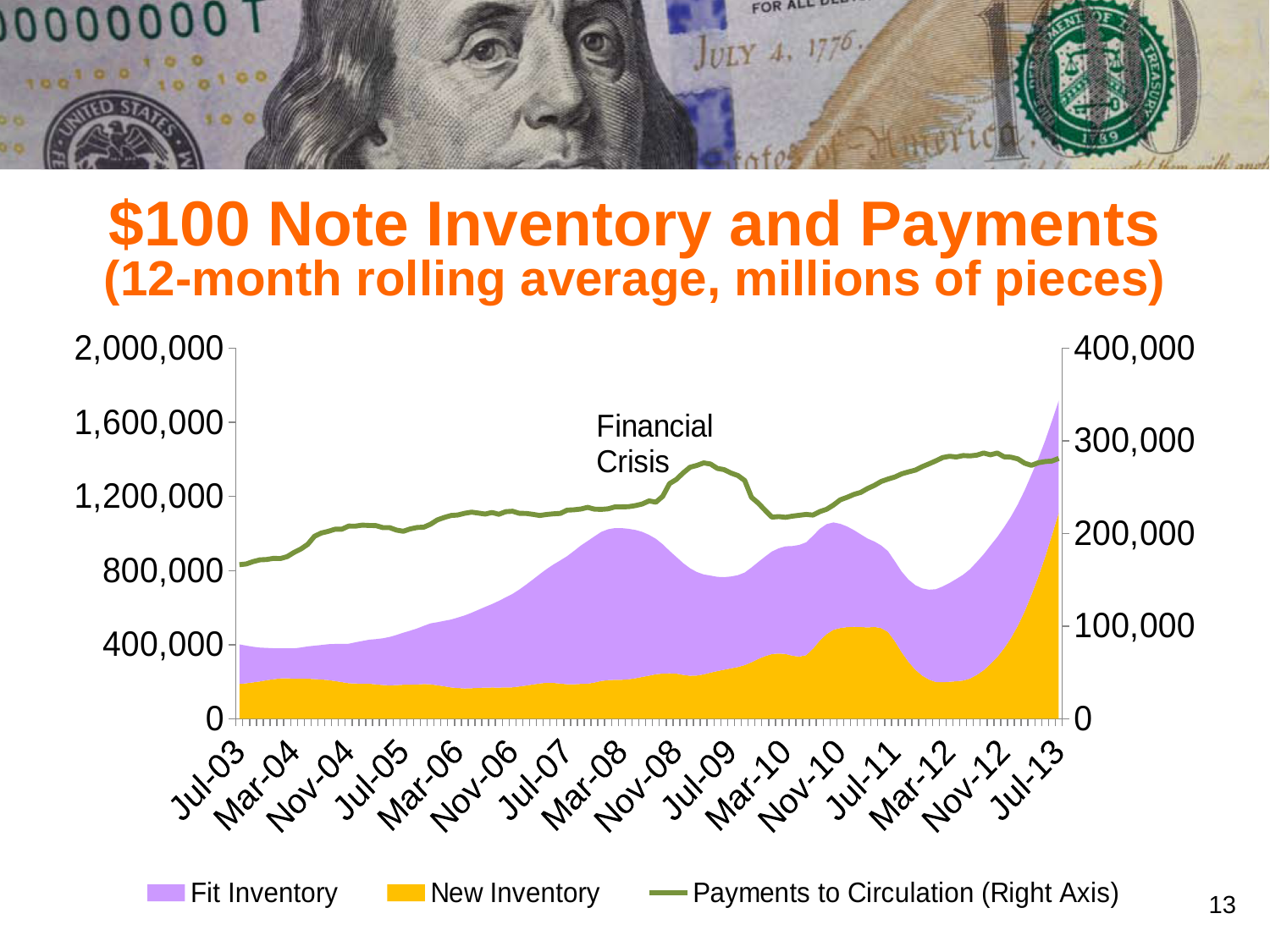
Is the value for Payments to Circulation at Jul-13 greater or less than 200,000? greater What text annotation appears above the line near Nov-08 to Jul-09? Financial Crisis Is the value for Payments to Circulation at Jul-03 greater or less than 200,000? less How many series does the legend list? 3 Which series is plotted against the right axis? Payments to Circulation Is the value for New Inventory at Jul-03 greater or less than 400,000? less What kind of chart is shown on the slide? Area chart with a line How many date labels are shown on the x axis? 16 Does Payments to Circulation generally rise or fall from Jul-03 to Jul-13? Rise What is the maximum value shown on the right axis? 400,000